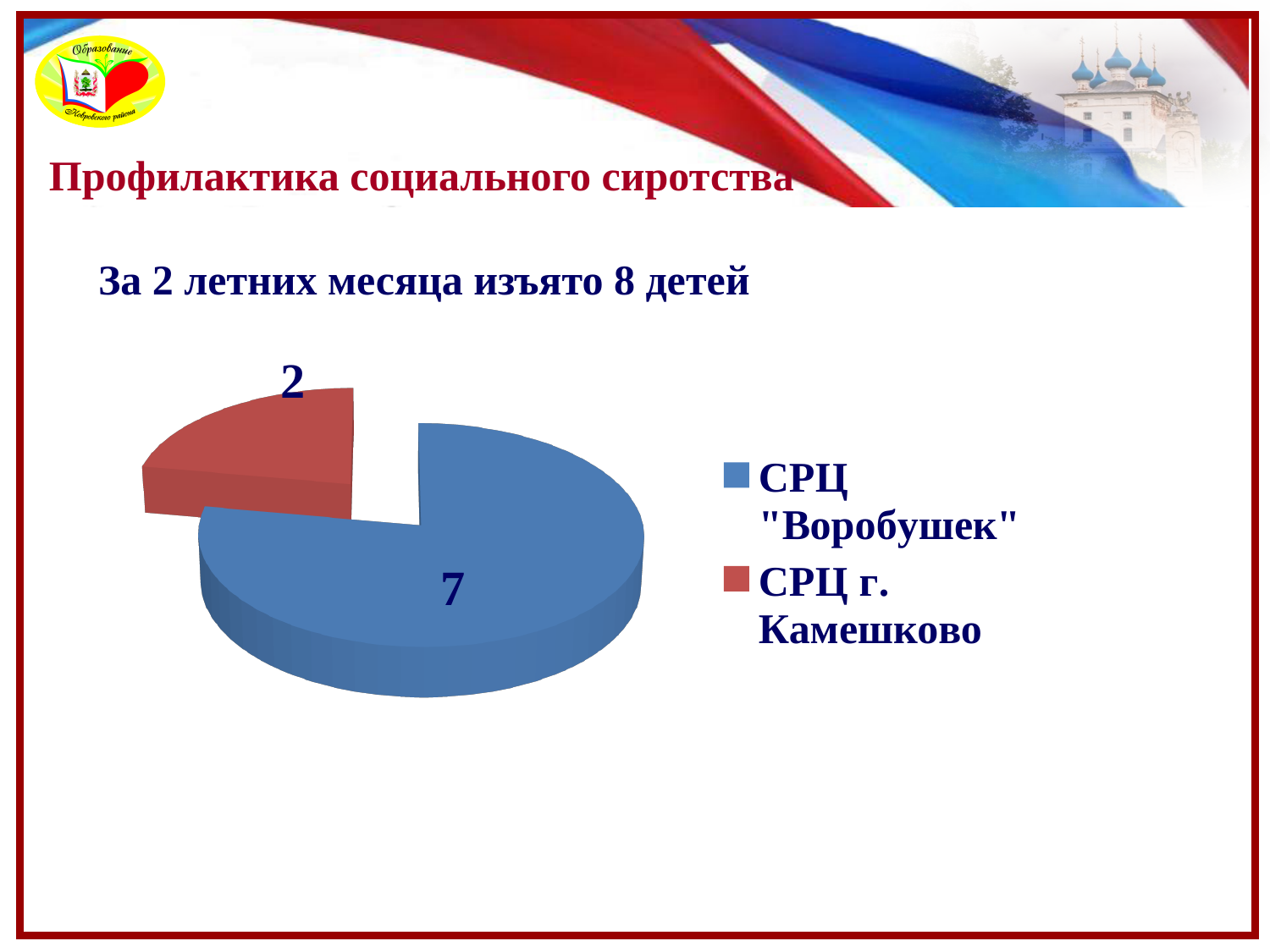
Which category has the smallest slice in the pie chart? СРЦ г. Камешково What type of chart is shown on the slide? Pie chart Which is larger: the value for СРЦ "Воробушек" or the value for СРЦ г. Камешково? СРЦ "Воробушек" Which category has the largest slice in the pie chart? СРЦ "Воробушек" What value is shown for the СРЦ г. Камешково slice of the pie chart? 2 How many slices does the pie chart have? 2 What is the difference between the values for СРЦ "Воробушек" and СРЦ г. Камешково? 5 What colour is the slice for СРЦ г. Камешково? Red What is the sum of the two values shown on the pie chart? 9 How many entries does the legend of the chart list? 2 Which legend entry is shown in blue? СРЦ "Воробушек" What value is shown for the СРЦ "Воробушек" slice of the pie chart? 7